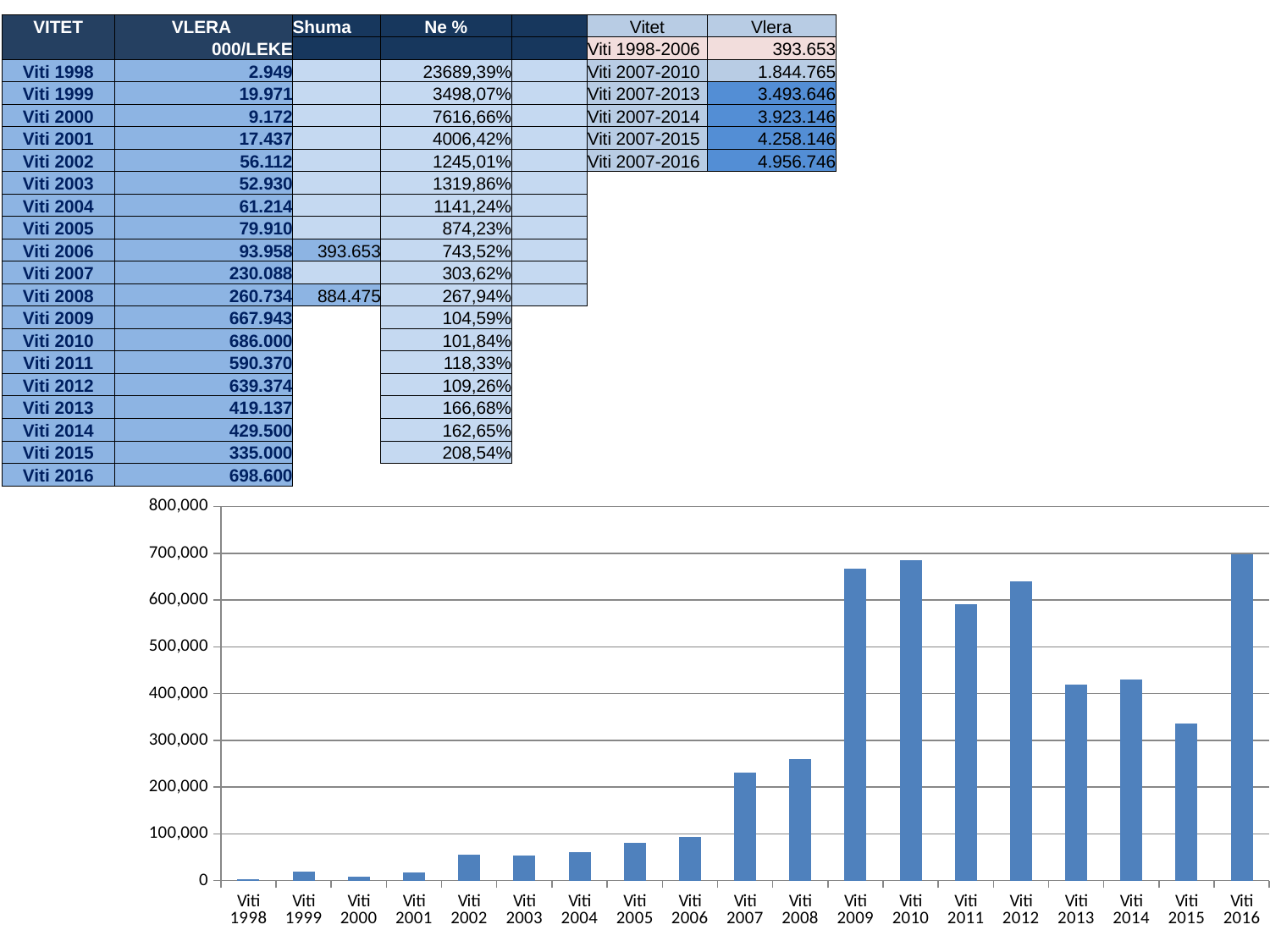
Do the bar values generally rise or fall from Viti 1998 to Viti 2010? rise Is the bar for Viti 2015 greater or less than 400,000? less Which year has the shortest bar in the chart? Viti 1998 According to the table on the slide, what is the VLERA value for Viti 2016? 698.600 Is the bar for Viti 2006 greater or less than 100,000? less Is the bar for Viti 2009 greater or less than 600,000? greater Which bar is taller, Viti 2007 or Viti 2008? Viti 2008 Which year has the tallest bar in the chart? Viti 2016 Which bar is taller, Viti 2011 or Viti 2012? Viti 2012 What is the highest tick value shown on the chart's vertical axis? 800,000 How many year categories are plotted on the x axis of the bar chart? 19 What kind of chart is shown at the bottom of the slide? bar chart